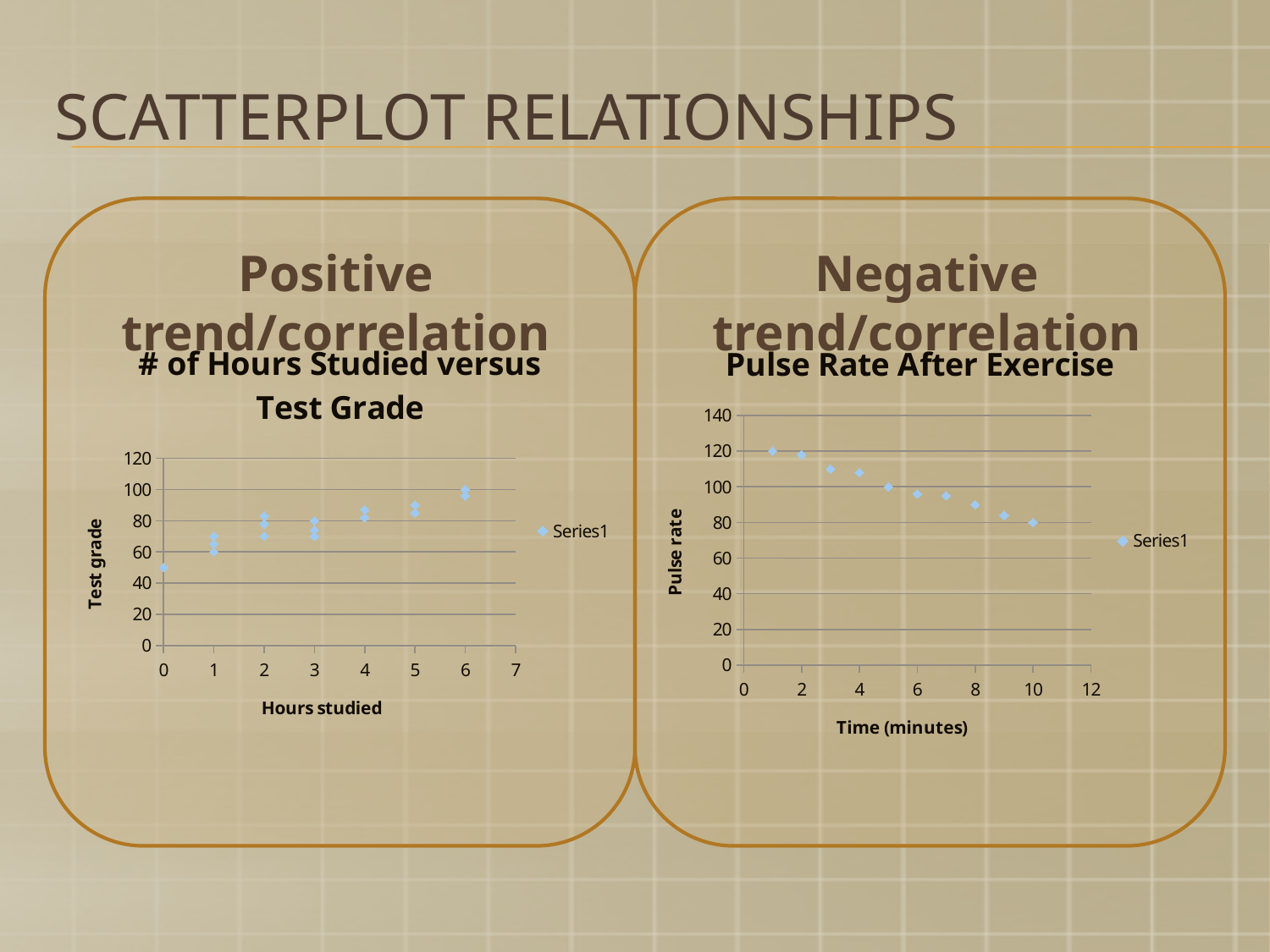
In the '# of Hours Studied versus Test Grade' chart, is the test grade at 0 hours studied greater or less than 60? less How many series does the legend of the 'Pulse Rate After Exercise' chart list? 1 In the 'Pulse Rate After Exercise' chart, what is the pulse rate at 10 minutes? 80 What kind of chart is the '# of Hours Studied versus Test Grade' chart? scatter plot In the 'Pulse Rate After Exercise' chart, what is the pulse rate at 5 minutes? 100 How many data points are plotted in the 'Pulse Rate After Exercise' chart? 10 In the 'Pulse Rate After Exercise' chart, do the values rise or fall as time increases? fall In the '# of Hours Studied versus Test Grade' chart, do test grades generally rise or fall as hours studied increase? rise What is the x-axis label of the 'Pulse Rate After Exercise' chart? Time (minutes) What kind of chart is the 'Pulse Rate After Exercise' chart? scatter plot In the 'Pulse Rate After Exercise' chart, is the pulse rate at 1 minute greater or less than 100? greater In the 'Pulse Rate After Exercise' chart, is the pulse rate at 9 minutes greater or less than 100? less